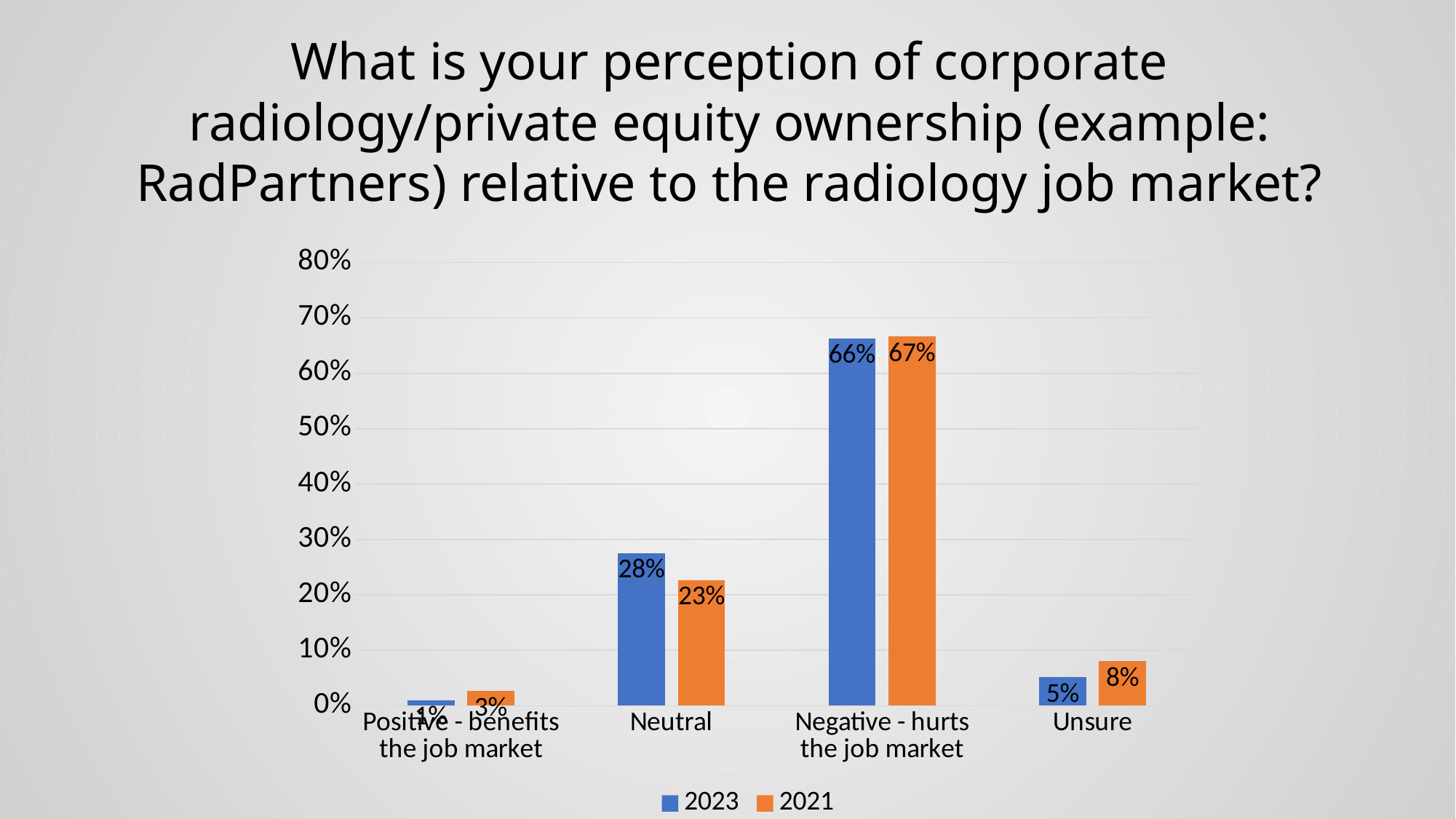
What is the difference between the 2023 and 2021 values for Neutral? 5% Which category has the lowest 2023 value? Positive - benefits the job market What kind of chart is shown on the slide? bar chart Which is larger for Unsure, the 2023 value or the 2021 value? 2021 What is the 2023 value for Neutral? 28% What is the 2021 value for Unsure? 8% How many categories are shown on the x axis? 4 What is the 2023 value for Negative - hurts the job market? 66% Which category has the highest 2021 value? Negative - hurts the job market Is the 2021 value for Negative - hurts the job market greater or less than 60%? greater What is the 2021 value for Positive - benefits the job market? 3% How many series does the legend list? 2